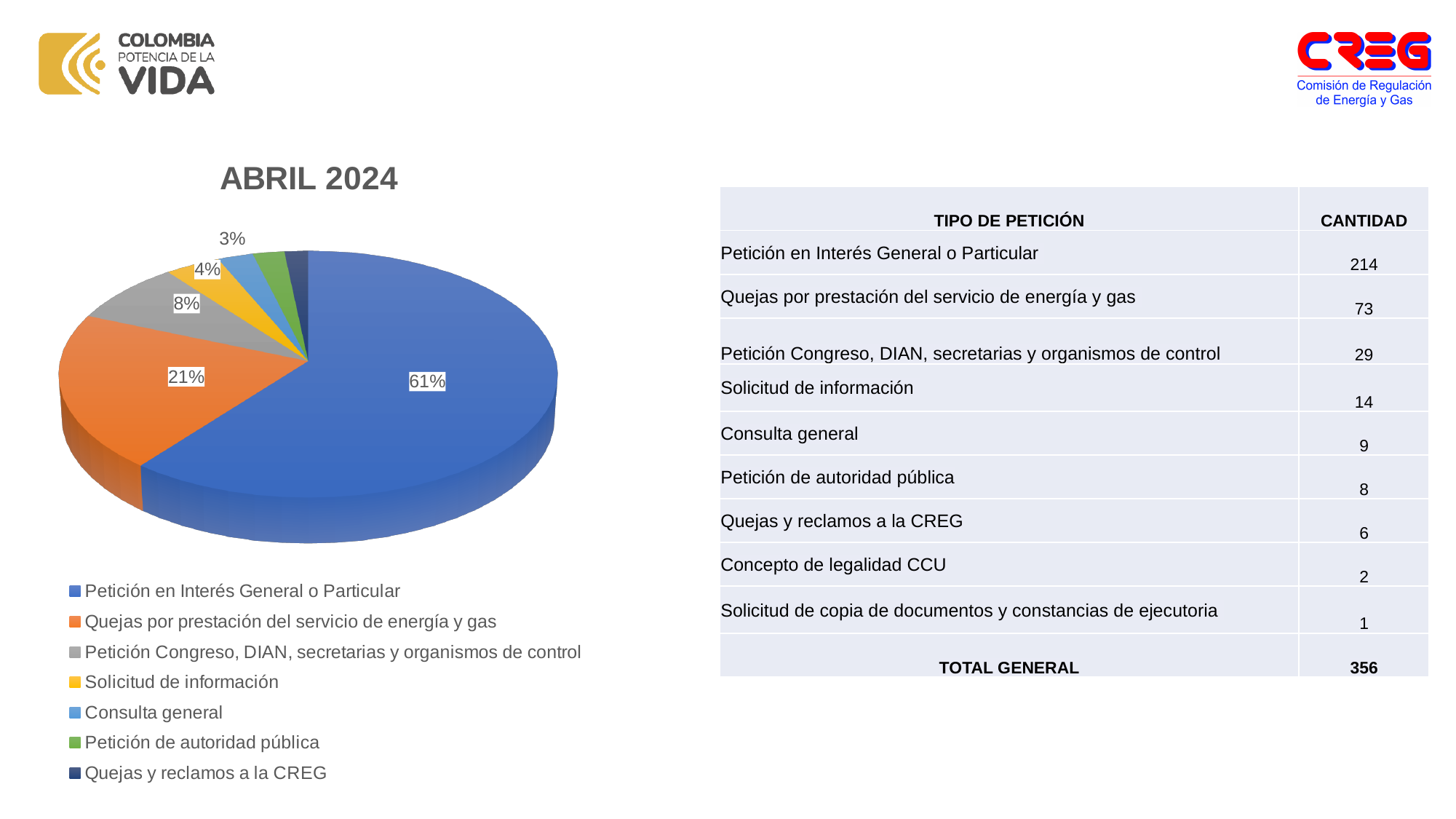
Which slice is larger: 'Solicitud de información' or 'Petición Congreso, DIAN, secretarias y organismos de control'? Petición Congreso, DIAN, secretarias y organismos de control By how many percentage points does the 'Petición en Interés General o Particular' slice exceed the 'Quejas por prestación del servicio de energía y gas' slice? 40 percentage points What is the title of the pie chart? ABRIL 2024 What share of the pie does 'Quejas por prestación del servicio de energía y gas' represent? 21% Which slice is larger: 'Quejas por prestación del servicio de energía y gas' or 'Petición Congreso, DIAN, secretarias y organismos de control'? Quejas por prestación del servicio de energía y gas What colour is the slice for 'Petición en Interés General o Particular'? blue What share of the pie does 'Solicitud de información' represent? 4% How many categories does the pie chart's legend list? 7 Which category has the largest slice in the pie chart? Petición en Interés General o Particular What share of the pie does 'Petición Congreso, DIAN, secretarias y organismos de control' represent? 8% What kind of chart is shown on the slide? pie chart